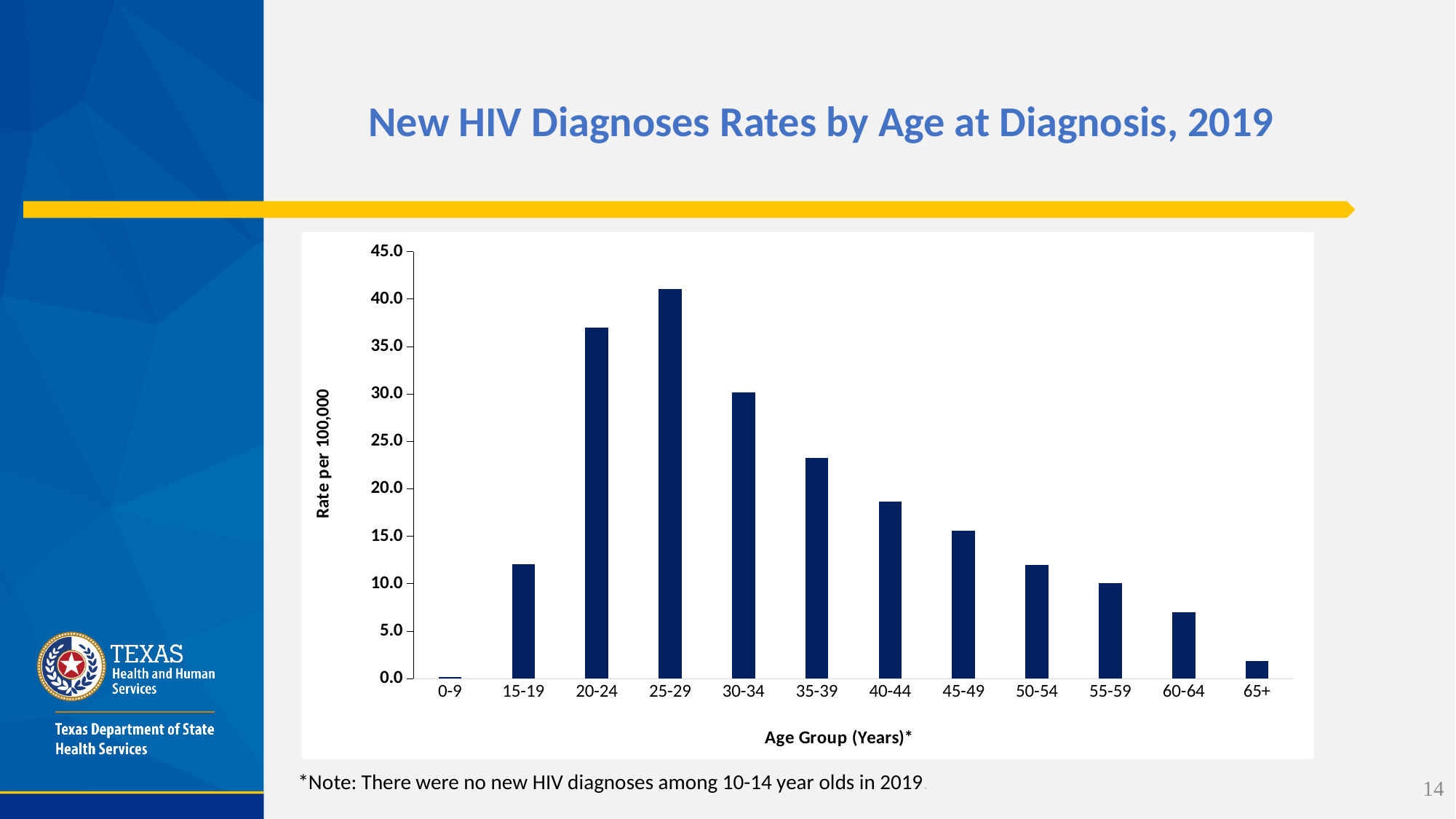
Is the value for the 65+ age group greater or less than 5.0? less Which age group has a higher rate, 20-24 or 30-34? 20-24 Do the rates rise or fall across the age groups from 25-29 to 65+? fall Which age group has the lowest new HIV diagnosis rate? 0-9 What kind of chart is shown on the slide? Bar chart Is the value for the 60-64 age group greater or less than 5.0? greater Is the value for the 40-44 age group greater or less than 20.0? less How many age groups are shown on the x axis of the chart? 12 What is the label on the vertical axis of the chart? Rate per 100,000 Which age group has the highest new HIV diagnosis rate? 25-29